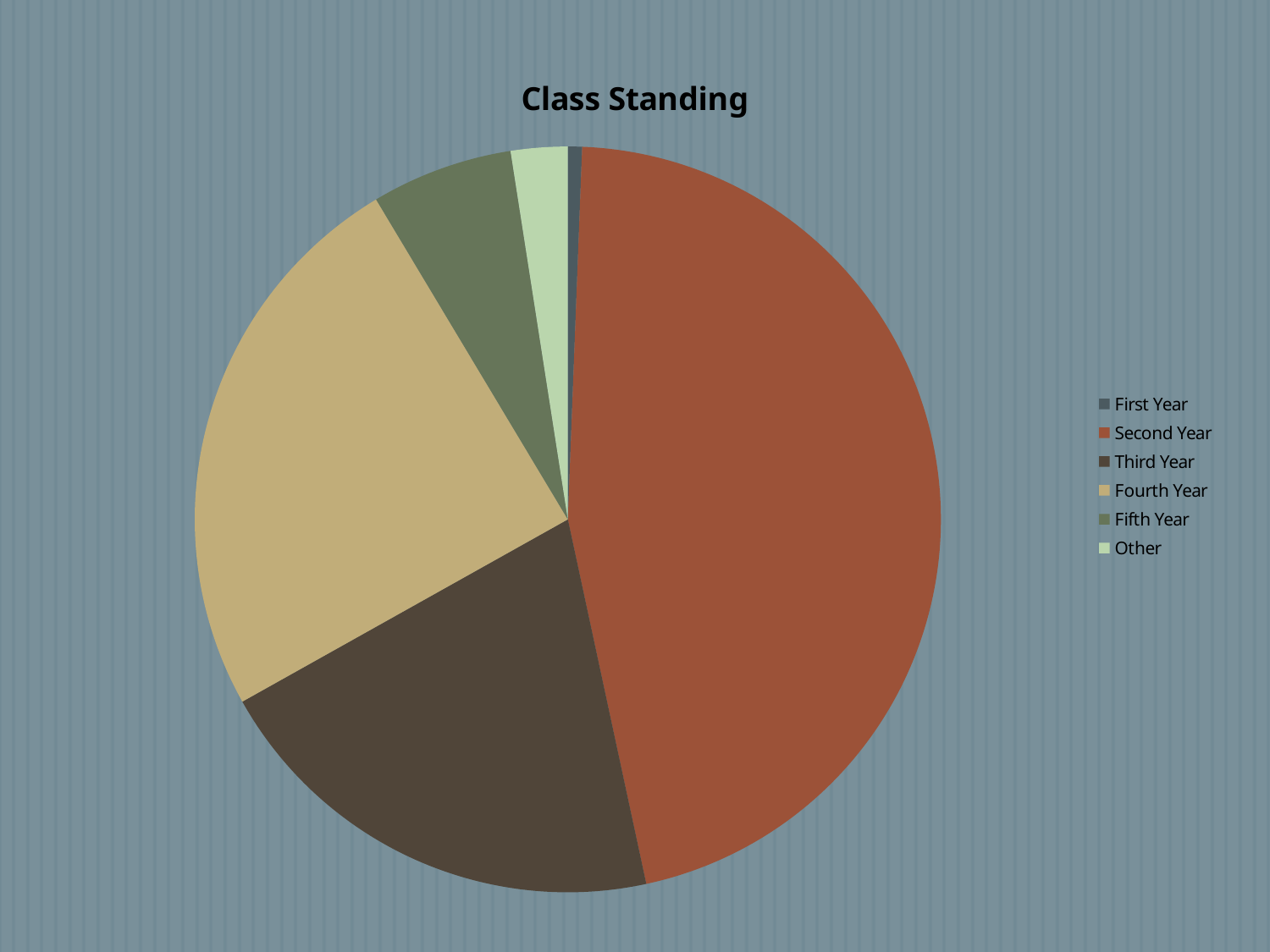
Which slice is larger, Fourth Year or Other? Fourth Year Which category is shown in the legend immediately after Third Year? Fourth Year Which slice is larger, Third Year or Fifth Year? Third Year Which category has the smallest slice of the pie? First Year Which slice is larger, Second Year or Fourth Year? Second Year What kind of chart is shown on the slide? pie chart Which category has the largest slice of the pie? Second Year How many slices does the pie chart have? 6 What is the title of the chart? Class Standing How many categories does the legend list? 6